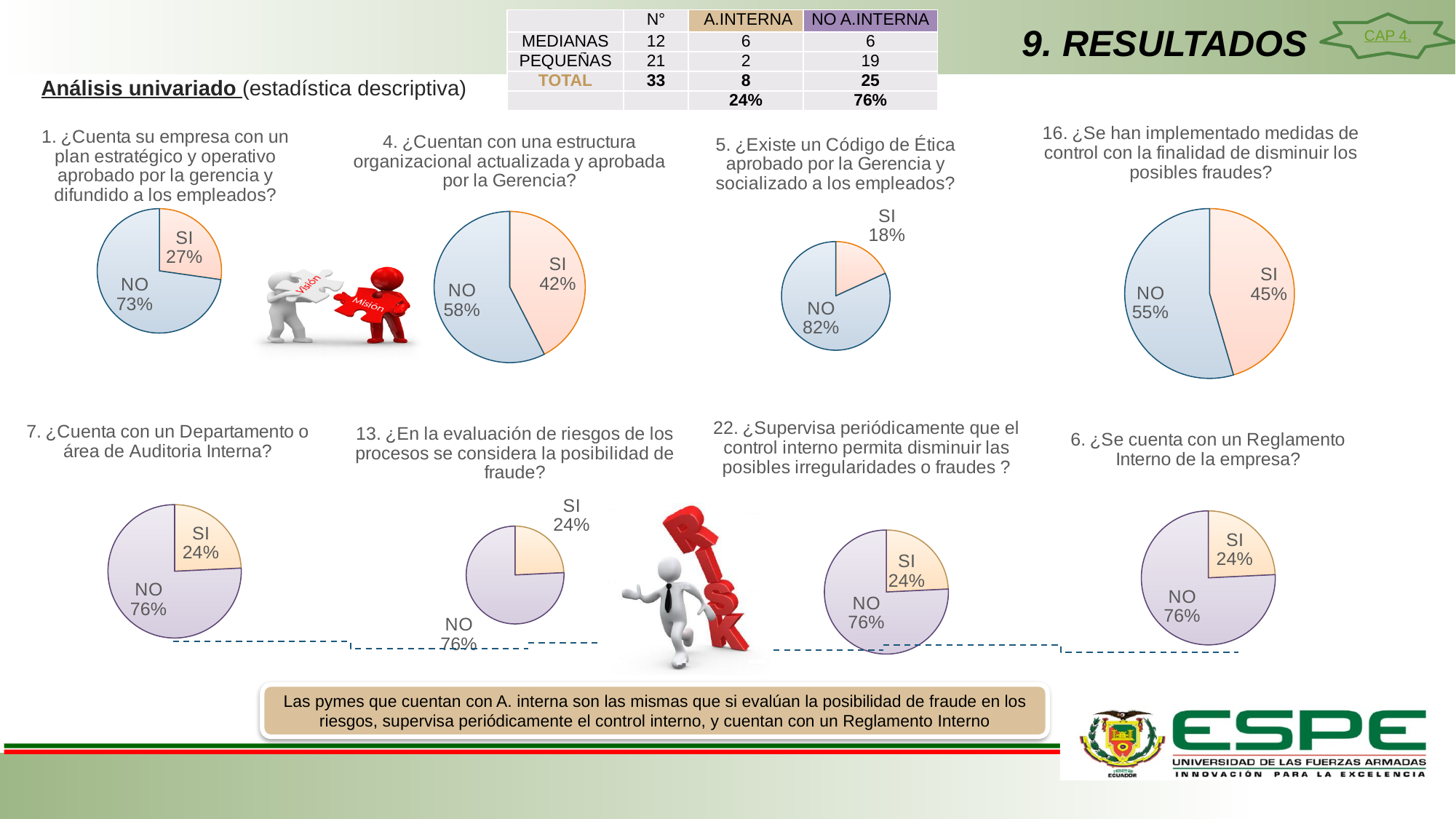
In the pie chart for question 16 (medidas de control contra fraudes), what is the difference between the NO and SI shares? 10% In the pie chart for question 4 (estructura organizacional actualizada), what share is labelled SI? 42% In the pie chart for question 7 (Departamento o área de Auditoria Interna), what share is labelled NO? 76% In the pie chart for question 1 (plan estratégico y operativo), what share is labelled NO? 73% What kind of chart is used for question 22 (supervisa periódicamente el control interno)? Pie chart In the pie chart for question 5 (Código de Ética), what is the difference between the NO and SI shares? 64% How many slices does the pie chart for question 6 (Reglamento Interno) have? 2 In the pie chart for question 4 (estructura organizacional actualizada), which slice is larger, SI or NO? NO